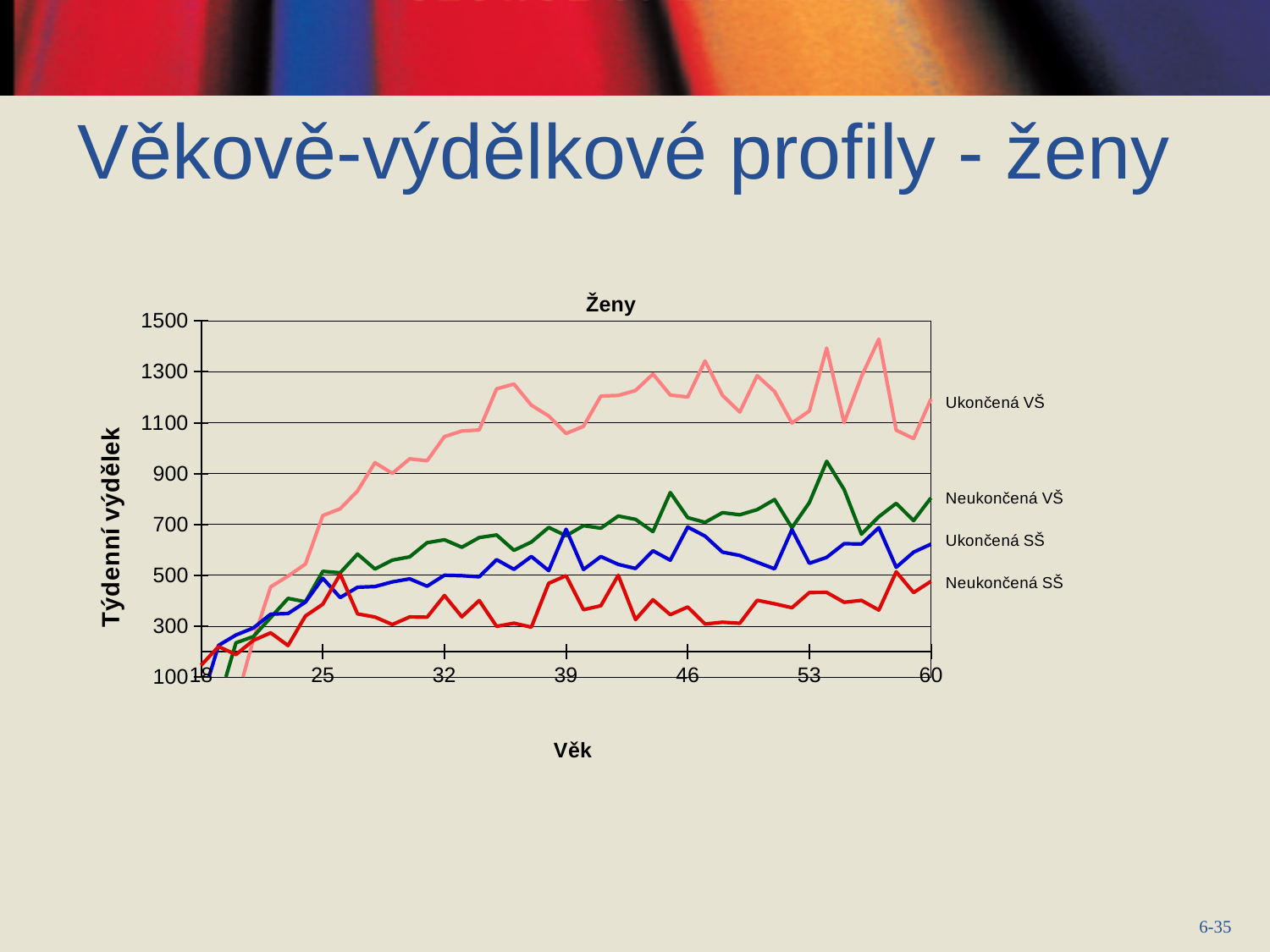
Which series has the lowest weekly earnings at age 60? Neukončená SŠ What is the title of the chart? Ženy Is the value for Ukončená SŠ at age 60 greater or less than 700? less At age 53, which series has the larger value: Ukončená VŠ or Ukončená SŠ? Ukončená VŠ What kind of chart is shown on the slide? line chart Is the value for Ukončená VŠ at age 46 greater or less than 1100? greater Which series has the highest weekly earnings across most of the age range? Ukončená VŠ Is the value for Neukončená VŠ at age 32 greater or less than 500? greater Does the Ukončená VŠ series generally rise or fall between ages 18 and 39? rise How many series are labelled on the chart? 4 What is the label of the x axis? Věk